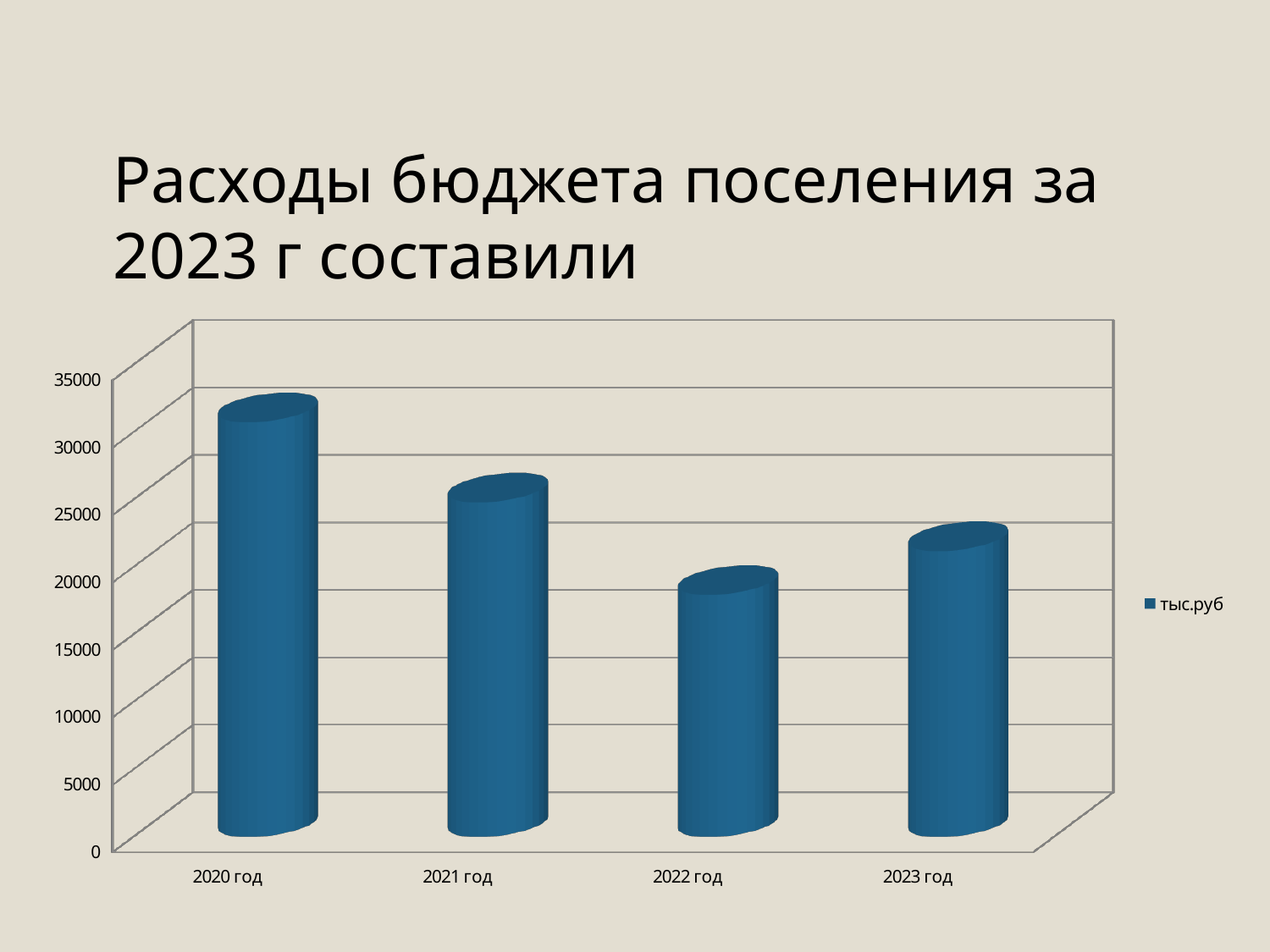
Is the value for 2022 год greater or less than 25000? less How many series does the chart legend list? 1 Is the value for 2020 год greater or less than 30000? greater Which is larger, the value for 2021 год or the value for 2023 год? 2021 год How many years (categories) are shown on the x axis of the chart? 4 Which is larger, the value for 2022 год or the value for 2023 год? 2023 год What kind of chart is shown on the slide? bar chart Which year has the highest value in the chart? 2020 год What is the legend entry shown for the series in the chart? тыс.руб Is the value for 2021 год greater or less than 30000? less Which year has the lowest value in the chart? 2022 год Do the values rise or fall from 2020 год to 2022 год? fall